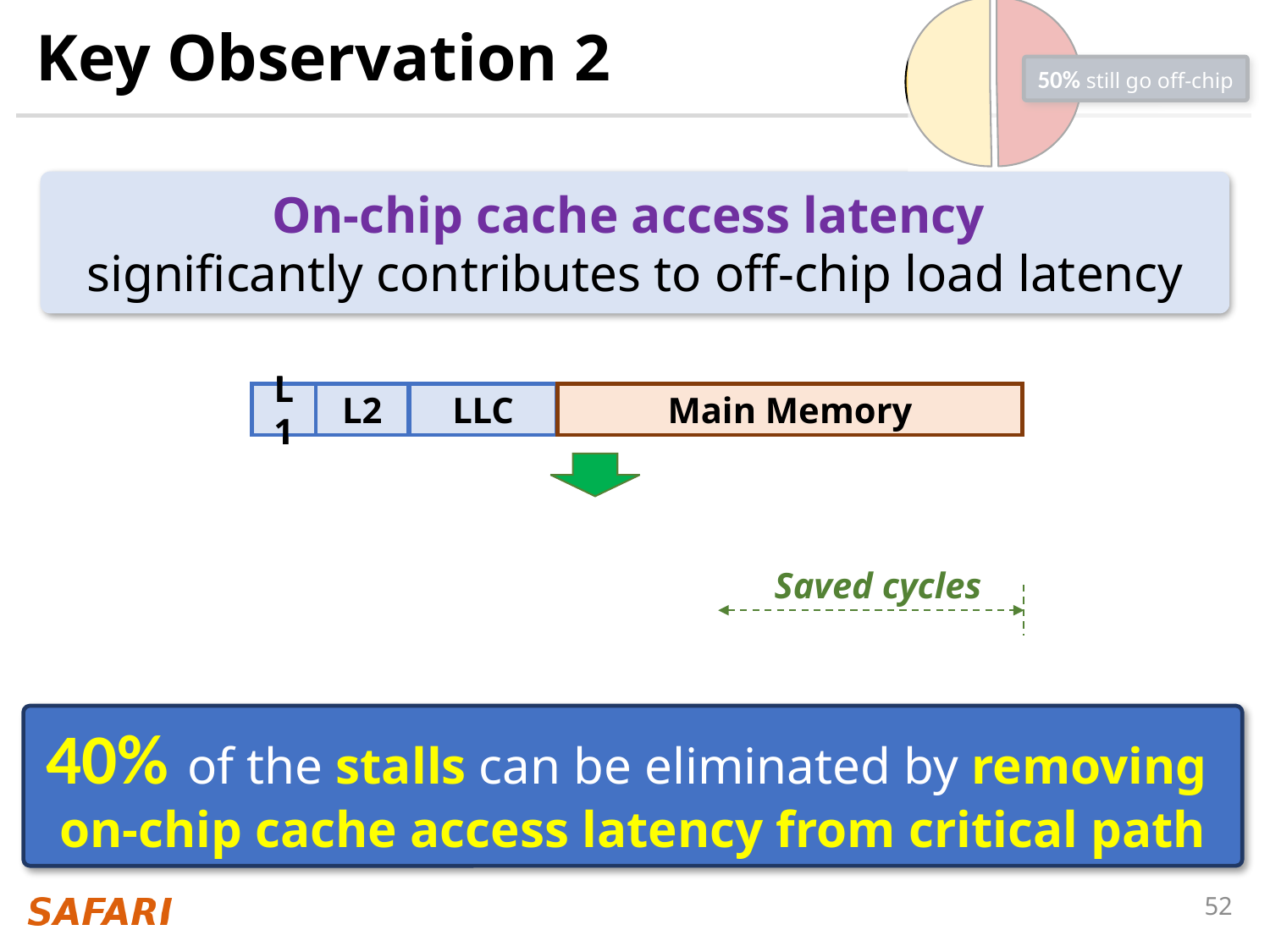
In the pie chart, is the slice labelled "still go off-chip" greater or less than 25% of the pie? greater In the pie chart, what share of the pie is labelled "still go off-chip"? 50% How many slices does the pie chart in the top-right corner have? 2 What kind of chart is shown in the top-right corner of the slide? pie chart In the pie chart, what colour is the slice labelled "50% still go off-chip"? pink